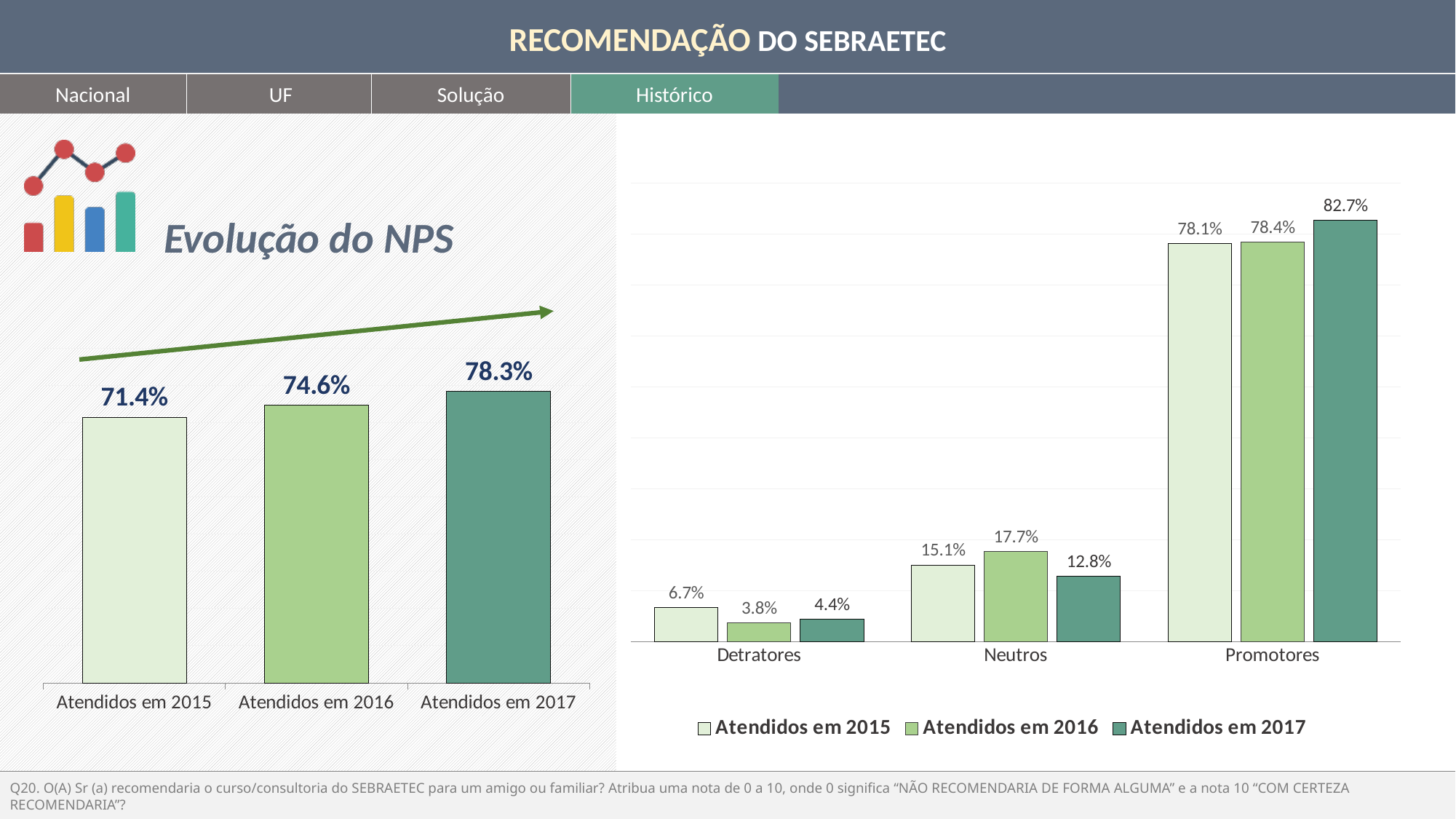
In the 'Evolução do NPS' chart on the left, what is the value for Atendidos em 2017? 78.3% In the 'Evolução do NPS' chart on the left, how many bars are plotted? 3 In the chart on the right, which year has the highest value for Neutros? Atendidos em 2016 In the chart on the right, what is the value for Neutros among Atendidos em 2015? 15.1% What kind of chart is the chart on the right? bar chart In the chart on the right, what is the value for Promotores among Atendidos em 2017? 82.7% In the 'Evolução do NPS' chart on the left, what is the difference between the 2017 and 2015 values? 6.9 percentage points In the chart on the right, how many series does the legend list? 3 In the chart on the right, what is the value for Detratores among Atendidos em 2016? 3.8% In the 'Evolução do NPS' chart on the left, do the values rise or fall from 2015 to 2017? rise In the 'Evolução do NPS' chart on the left, what is the value for Atendidos em 2015? 71.4% In the chart on the right, which year has the lowest value for Detratores? Atendidos em 2016